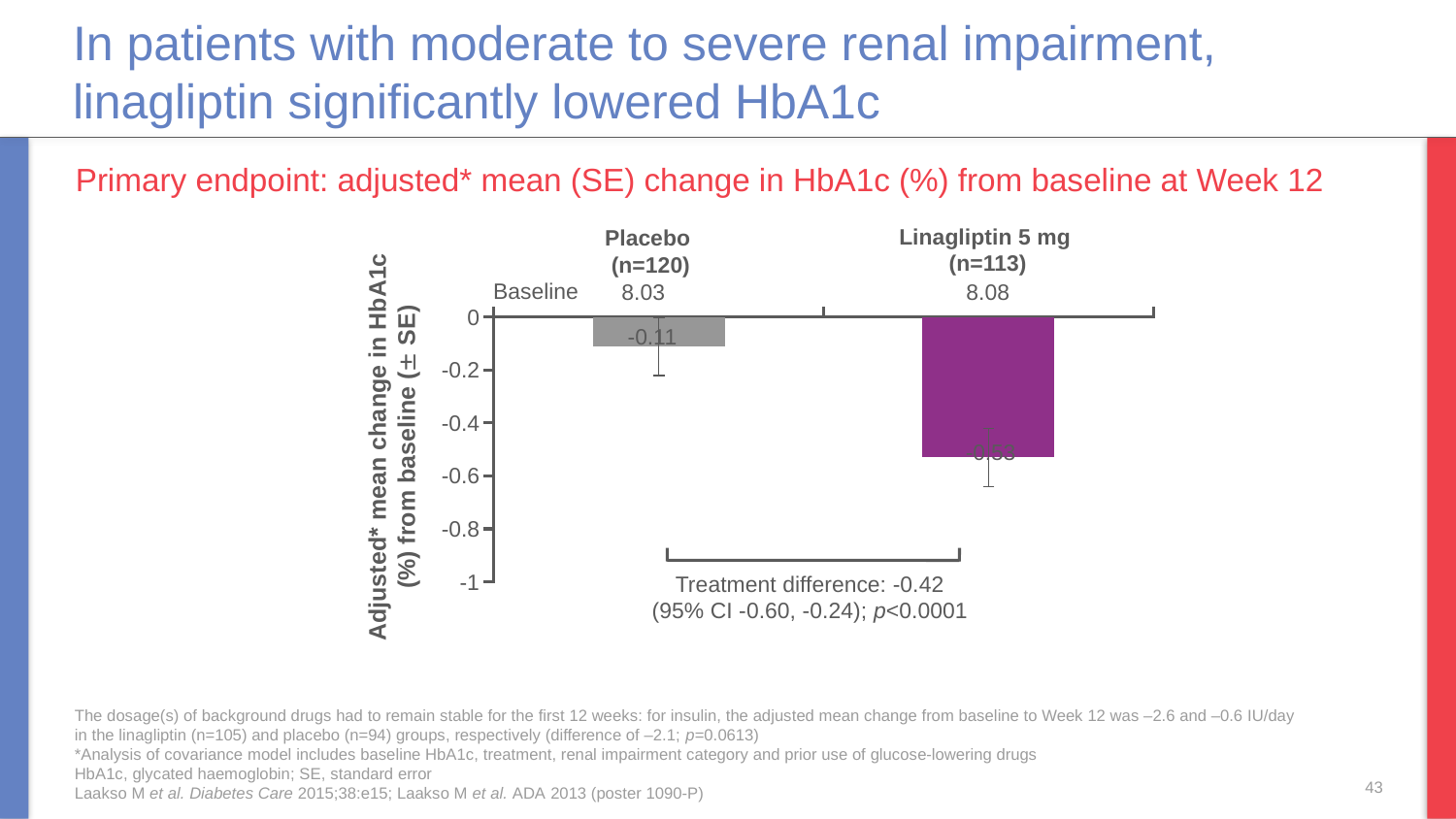
What is the 95% confidence interval for the treatment difference? -0.60, -0.24 What is the lowest value shown on the y-axis? -1 How many bars are plotted in the chart? 2 What kind of chart is shown on the slide? Bar chart Which bar is larger in magnitude, Placebo or Linagliptin 5 mg? Linagliptin 5 mg What treatment difference is reported below the chart? -0.42 Is the value for Linagliptin 5 mg greater or less than -0.4? less Which group shows the lower (more negative) change in HbA1c from baseline? Linagliptin 5 mg What is the baseline HbA1c value shown for the Linagliptin 5 mg group? 8.08 What is the adjusted mean change in HbA1c from baseline for the Placebo group? -0.11 What is the baseline HbA1c value shown for the Placebo group? 8.03 How many patients (n) are in the Placebo group? 120